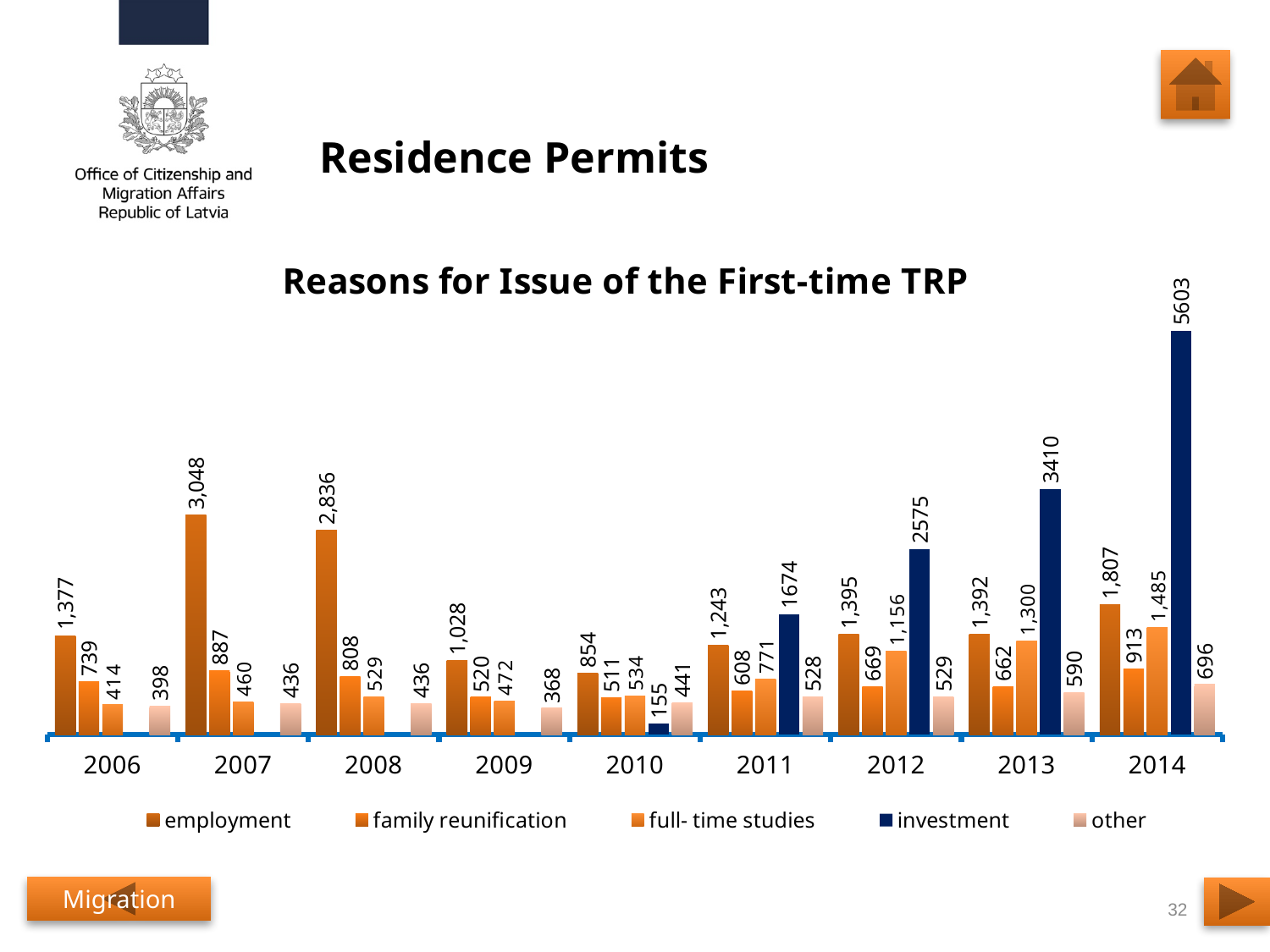
Does the value for investment rise or fall from 2010 to 2014? rise What is the value for other in 2009? 368 Which year has the lowest value for employment? 2010 What is the value for employment in 2007? 3,048 What is the value for full-time studies in 2012? 1,156 What is the difference between the investment values in 2014 and 2013? 2193 Which is larger in 2011: the value for full-time studies or the value for family reunification? full-time studies What kind of chart is shown on the slide? bar chart How many series does the legend list? 5 What is the value for investment in 2014? 5603 Which year has the highest value for investment? 2014 How many years are shown on the x axis? 9